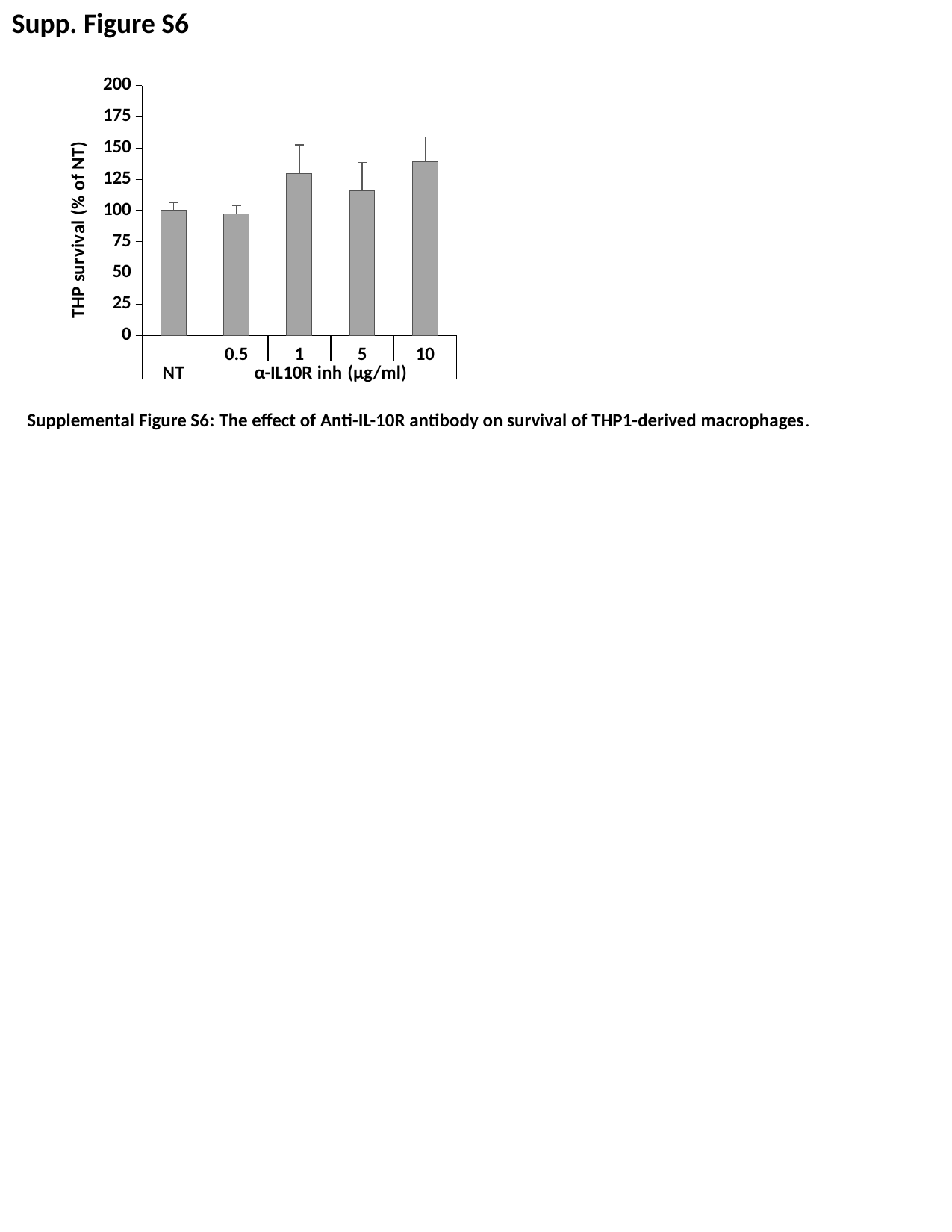
Is the THP survival for 10 µg/ml α-IL10R inh greater or less than 125? greater Is the THP survival for 0.5 µg/ml α-IL10R inh greater or less than 75? greater What is the label under the treated bars on the x axis? α-IL10R inh (µg/ml) Which has higher THP survival, NT or 10 µg/ml α-IL10R inh? 10 µg/ml Is the THP survival for 1 µg/ml α-IL10R inh greater or less than 100? greater Which has higher THP survival, 1 µg/ml or 5 µg/ml α-IL10R inh? 1 µg/ml How many bars are plotted in the chart? 5 Which concentration of α-IL10R inh gives the highest THP survival? 10 What is the label of the y axis? THP survival (% of NT) What kind of chart is shown on the slide? bar chart What is the THP survival value for NT? 100